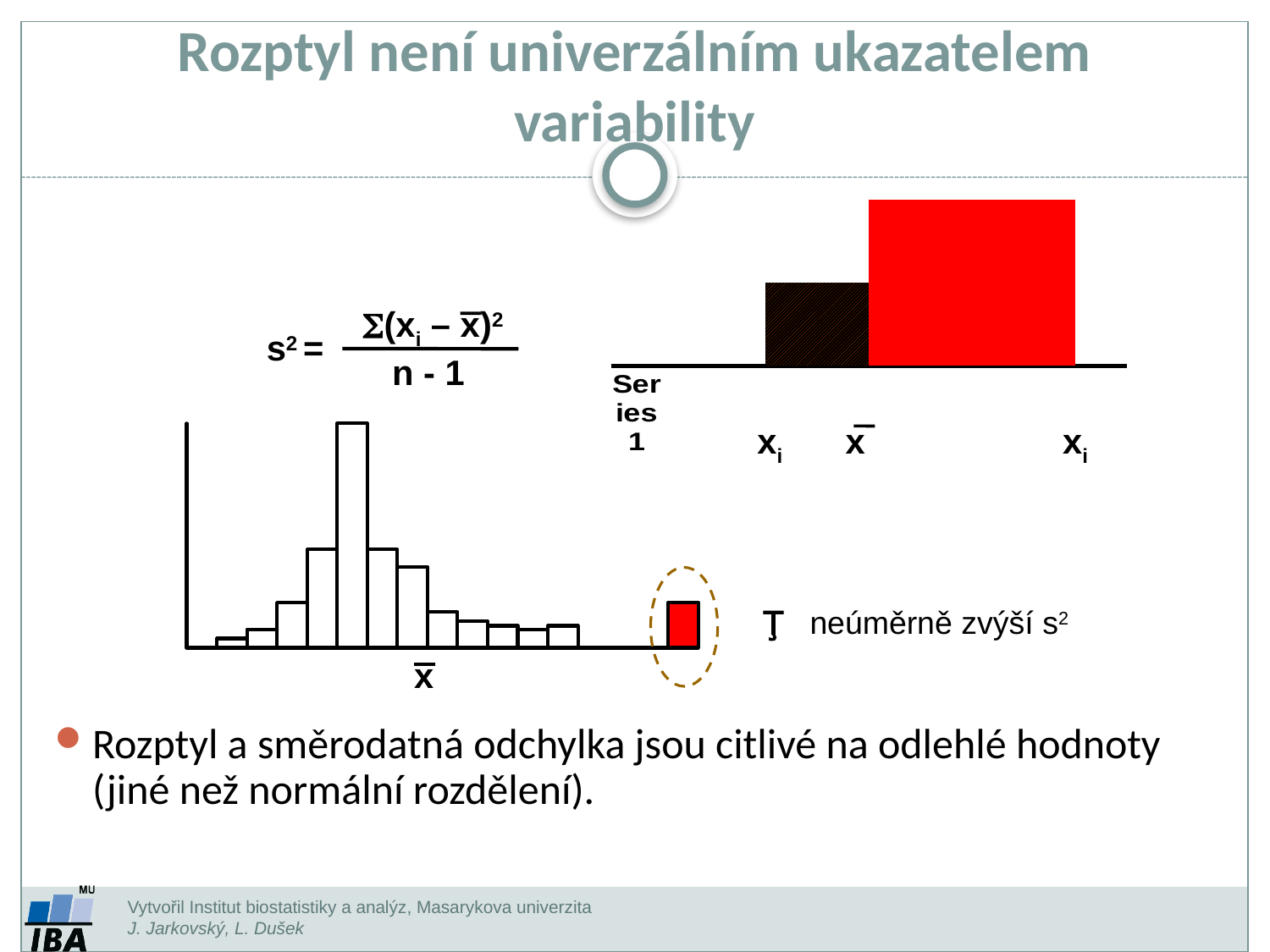
In the lower-left chart, is the red bar at the far right taller or shorter than the tallest white bar? shorter In the top-right chart, what colour is the taller bar? red What kind of chart is shown in the top-right corner of the slide, next to the variance formula? bar chart In the top-right chart, what is the only series label shown below the axis? Series 1 In the top-right chart, which bar is taller, the hatched black bar or the red bar? the red bar What kind of chart is the larger drawing in the lower-left part of the slide, with the x̄ label beneath it? bar chart In the lower-left chart, is the tallest bar located near the x̄ label or at the far right end of the axis? near the x̄ label In the top-right chart, how many bars are plotted? 2 In the lower-left chart, do the bar heights rise or fall moving from the tallest bar toward the right end of the axis (before the red bar)? fall In the lower-left chart, how many bars are filled red? 1